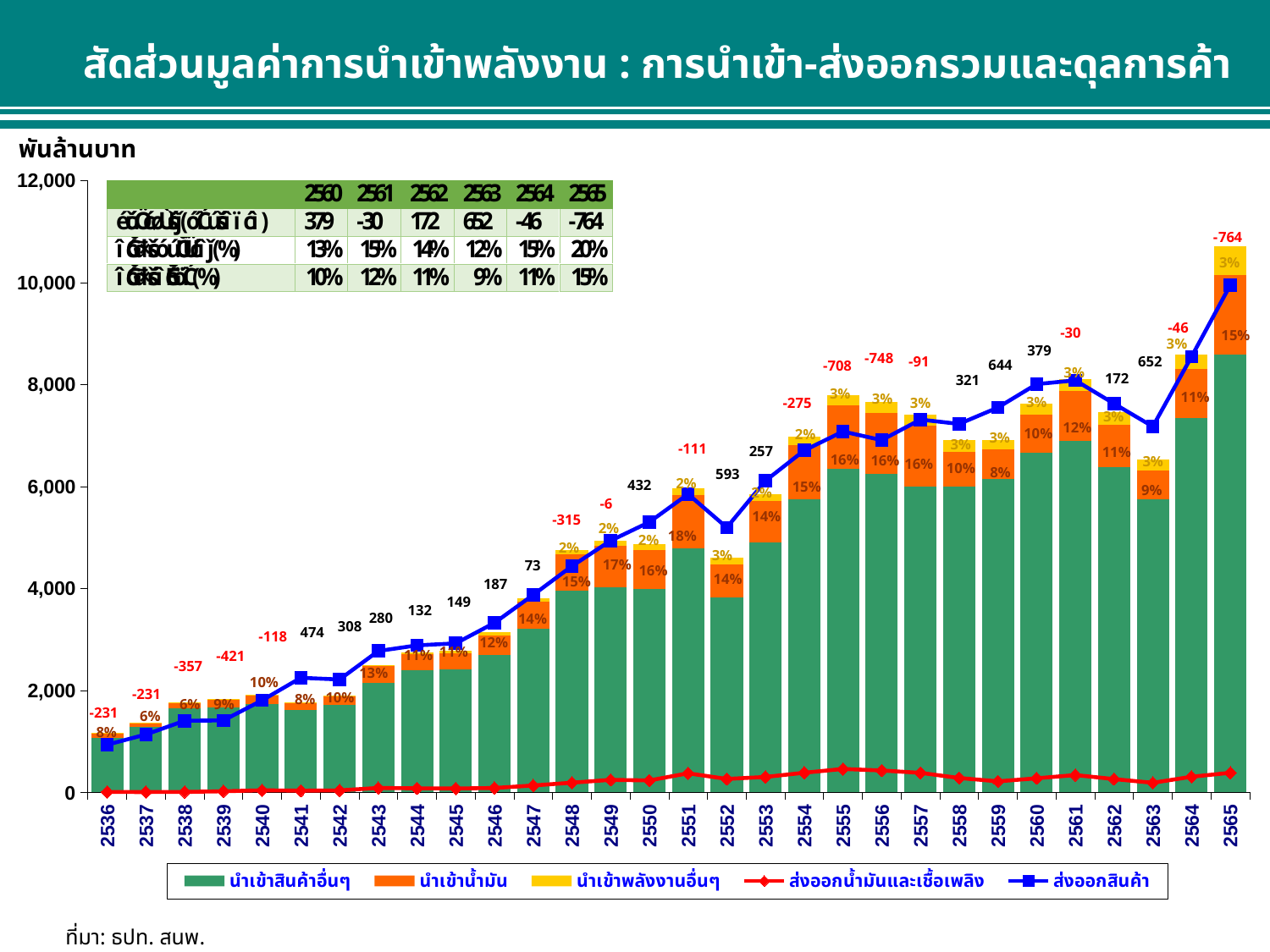
What unit is stated above the chart's y axis? พันล้านบาท What value is labelled above the bar for 2541? 474 What value is labelled above the bar for 2565? -764 What kind of chart is shown on the slide? stacked bar chart with line series Which year has the lowest value among the labels printed above the bars? 2565 Is the ส่งออกสินค้า (blue line) value for 2565 greater or less than 8,000? greater What percentage is labelled on the นำเข้าน้ำมัน (orange) segment for 2551? 18% What is the difference between the labels above the bars for 2563 (652) and 2562 (172)? 480 How many series does the legend list? 5 How many years (categories) are shown along the x axis? 30 Which year has the larger นำเข้าน้ำมัน percentage label, 2549 or 2552? 2549 What value is labelled above the bar for 2563? 652